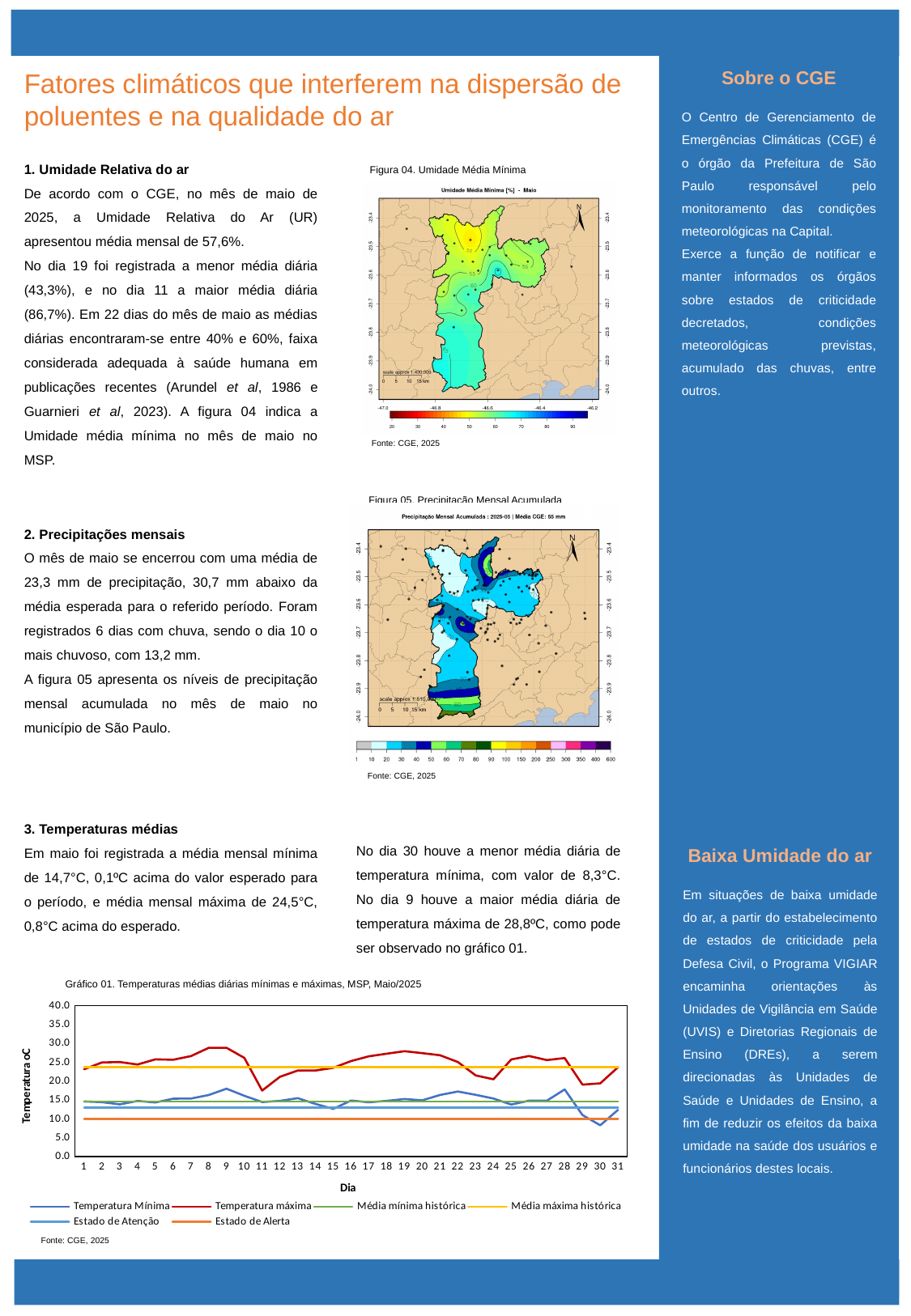
In Gráfico 01, which is larger: the Temperatura máxima on day 9 or on day 11? day 9 How many days are plotted along the x axis of Gráfico 01? 31 In Gráfico 01, on which day does the Temperatura Mínima series reach its lowest value? 30 What kind of chart is Gráfico 01 at the bottom of the slide? line chart What is the title of the line chart at the bottom of the slide? Gráfico 01. Temperaturas médias diárias mínimas e máximas, MSP, Maio/2025 How many series does the legend of Gráfico 01 list? 6 In Gráfico 01, is the Temperatura Mínima value on day 30 greater or less than 10.0? less In Gráfico 01, is the Temperatura máxima value on day 11 greater or less than 25.0? less In Gráfico 01, does the Temperatura máxima series rise or fall between day 9 and day 11? fall In Gráfico 01, on which day does the Temperatura máxima series reach its highest value? 9 What is the label of the x axis in Gráfico 01? Dia In Gráfico 01, is the Temperatura máxima value on day 9 greater or less than 25.0? greater